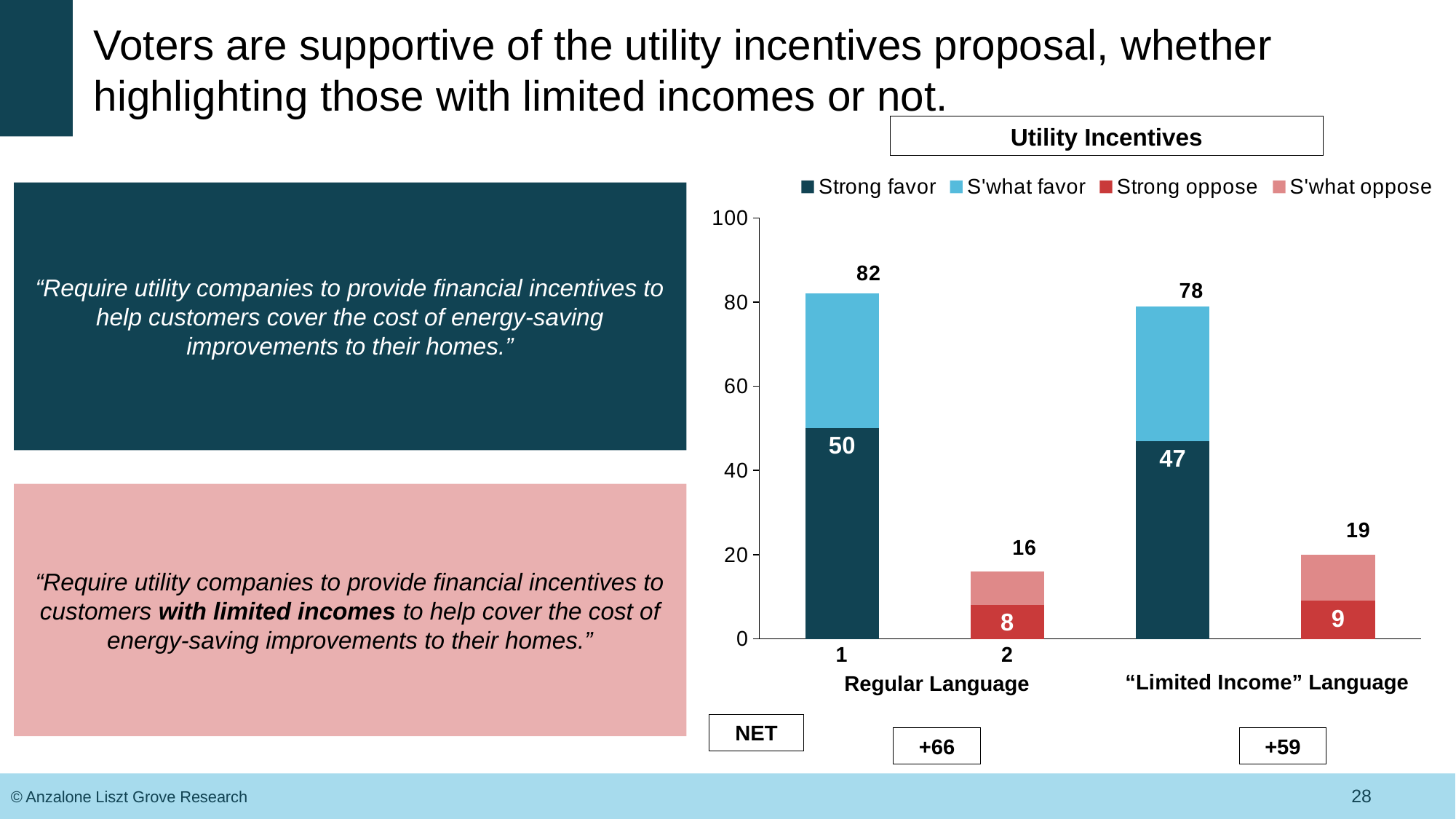
What is the Strong oppose value for "Limited Income" Language? 9 What is the difference between the total favor for Regular Language and the total favor for "Limited Income" Language? 4 What is the S'what favor value for Regular Language, given the total favor of 82 and Strong favor of 50? 32 What is the NET value shown for "Limited Income" Language? +59 What is the Strong favor value for Regular Language? 50 What is the total favor (Strong favor plus S'what favor) for the Regular Language bar? 82 What kind of chart is shown on the slide? Stacked bar chart How many series does the legend list? 4 What is the total oppose (Strong oppose plus S'what oppose) for the "Limited Income" Language bar? 19 Which language version has the higher total oppose value? "Limited Income" Language What is the Strong oppose value for Regular Language? 8 What is the Strong favor value for "Limited Income" Language? 47